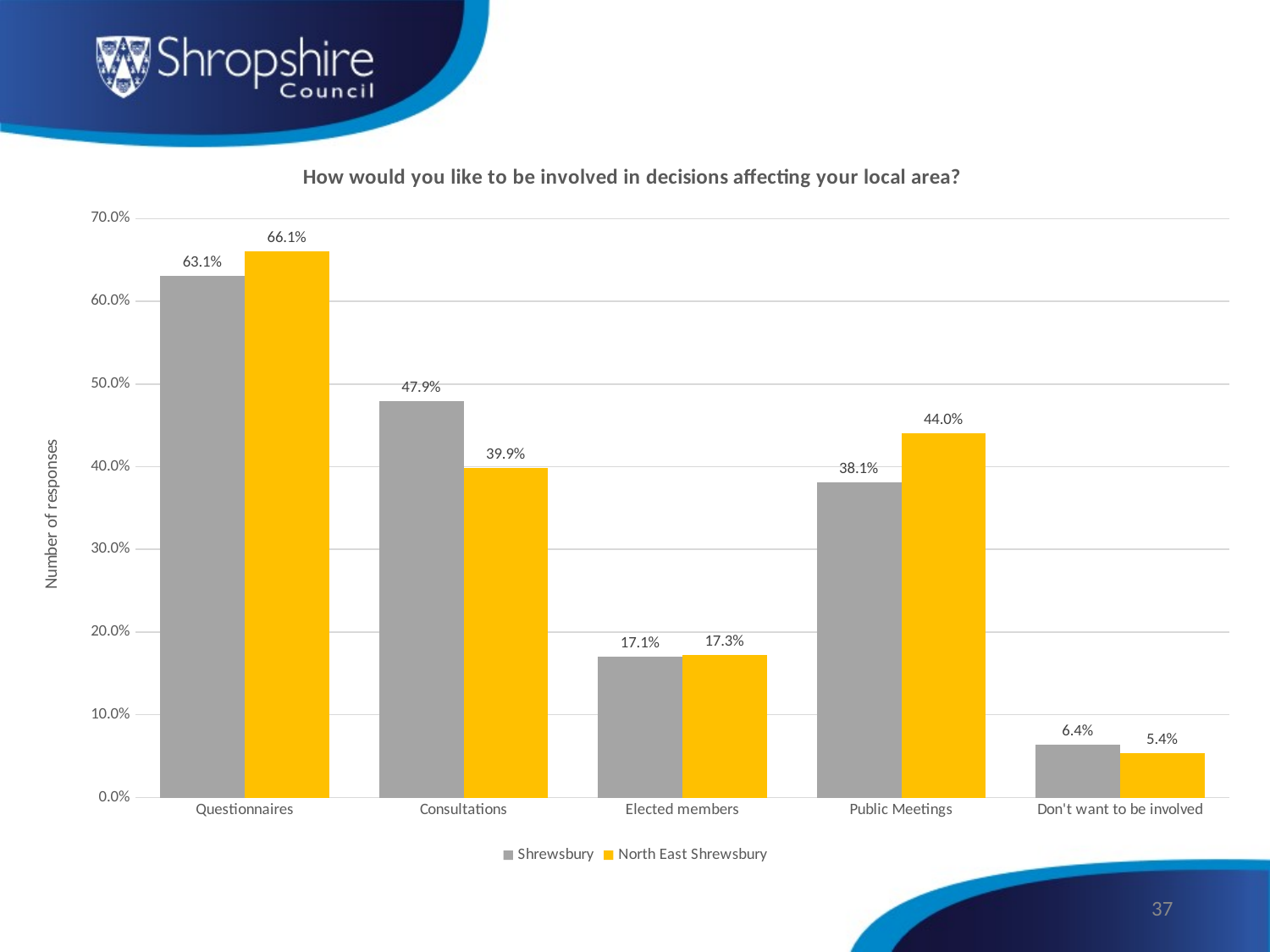
How many categories are shown on the x axis? 5 What is the Shrewsbury value for Questionnaires? 63.1% What is the North East Shrewsbury value for Consultations? 39.9% Is the Shrewsbury value for Consultations greater or less than 40.0%? greater How many series does the legend list? 2 What is the difference between the Shrewsbury and North East Shrewsbury values for Consultations? 8.0% Which category has the highest Shrewsbury value? Questionnaires What is the North East Shrewsbury value for Public Meetings? 44.0% Which category has the lowest North East Shrewsbury value? Don't want to be involved What is the difference between the North East Shrewsbury and Shrewsbury values for Questionnaires? 3.0% For Public Meetings, which series has the larger value, Shrewsbury or North East Shrewsbury? North East Shrewsbury What kind of chart is shown on the slide? Bar chart